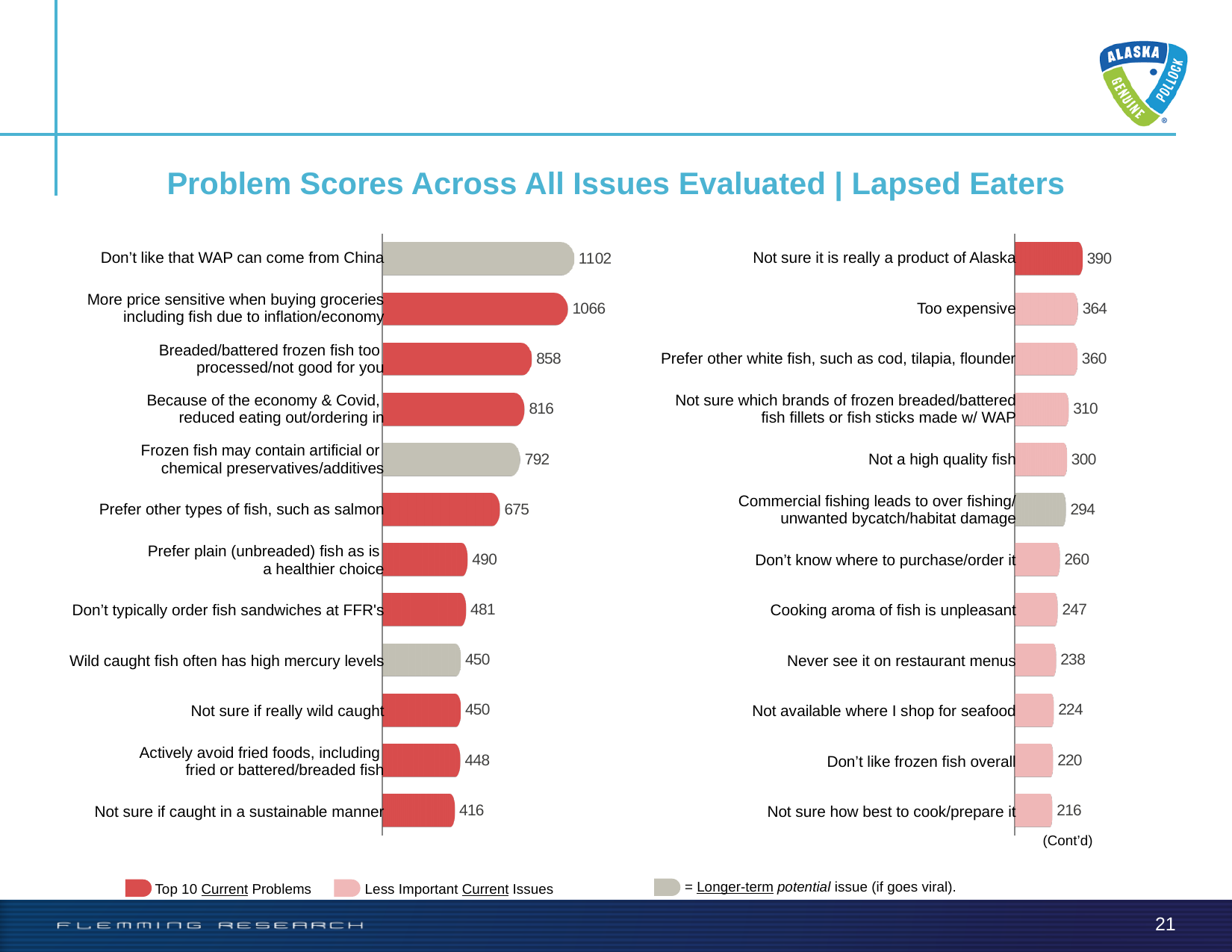
In the right chart, which has the larger score: "Not a high quality fish" or "Don't know where to purchase/order it"? Not a high quality fish What type of chart is used on this slide? Bar chart In the left chart, what is the difference between the scores for "Don't like that WAP can come from China" and "More price sensitive when buying groceries including fish due to inflation/economy"? 36 In the right chart, which issue has the lowest problem score? Not sure how best to cook/prepare it In the left chart, which issue has the highest problem score? Don't like that WAP can come from China In the right chart, what is the difference between the scores for "Not sure it is really a product of Alaska" and "Not sure how best to cook/prepare it"? 174 How many issues are shown in the left chart? 12 How many issues are shown in the right chart? 12 In the right chart, what is the problem score for "Too expensive"? 364 In the left chart, what is the problem score for "Prefer other types of fish, such as salmon"? 675 In the left chart, what is the problem score for "Don't like that WAP can come from China"? 1102 According to the legend, what does a grey bar represent? Longer-term potential issue (if goes viral)